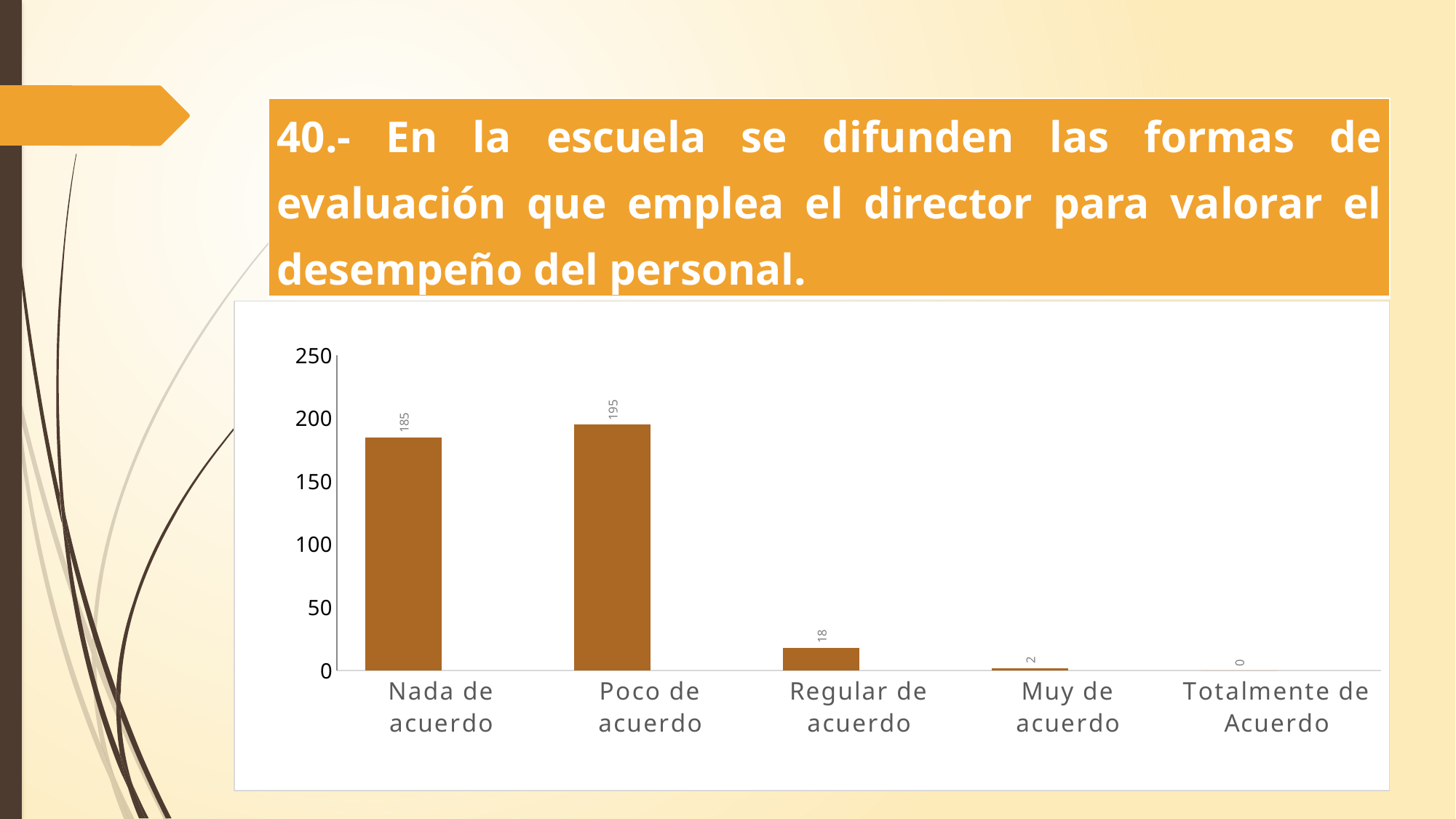
What is the value for "Totalmente de Acuerdo"? 0 What is the value for "Regular de acuerdo"? 18 What is the value for "Nada de acuerdo"? 185 Which is larger, the value for "Regular de acuerdo" or the value for "Muy de acuerdo"? Regular de acuerdo What is the value for "Muy de acuerdo"? 2 How many categories are shown on the x axis? 5 What is the highest value shown on the y axis? 250 What is the value for "Poco de acuerdo"? 195 What kind of chart is shown on the slide? Bar chart Which category has the lowest value? Totalmente de Acuerdo What is the difference between the values for "Poco de acuerdo" and "Nada de acuerdo"? 10 Which category has the highest value? Poco de acuerdo